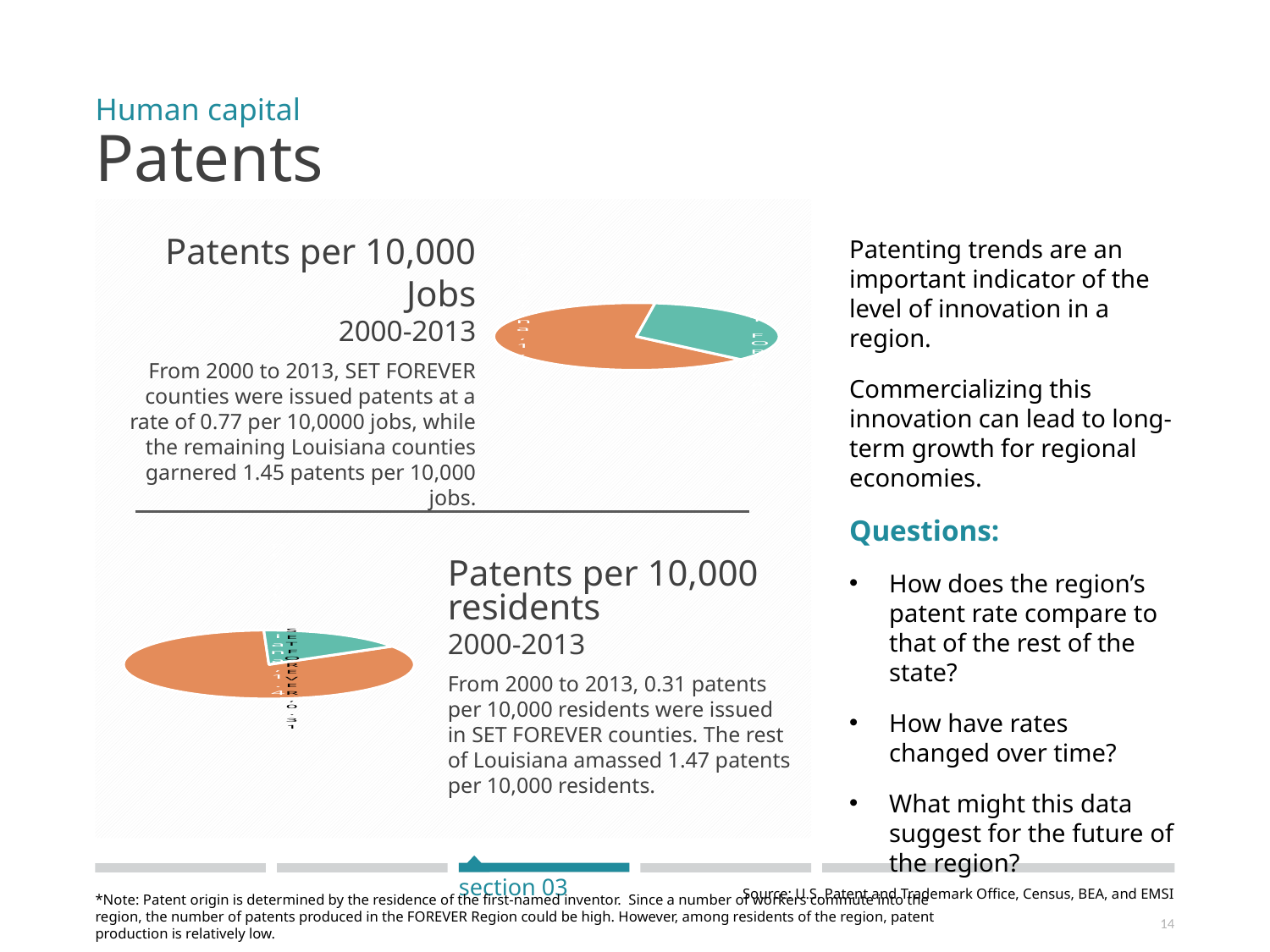
According to the slide, which had the higher rate of patents per 10,000 residents from 2000 to 2013, SET FOREVER counties or the rest of Louisiana? the rest of Louisiana What is the title of the pie chart at the top of the slide? Patents per 10,000 Jobs 2000-2013 What kind of chart is the 'Patents per 10,000 residents 2000-2013' chart? pie chart What time period do both pie charts on the slide cover? 2000-2013 How many slices does the 'Patents per 10,000 residents 2000-2013' pie chart have? 2 How many slices does the 'Patents per 10,000 Jobs 2000-2013' pie chart have? 2 According to the slide, which had the higher rate of patents per 10,000 jobs from 2000 to 2013, SET FOREVER counties or the remaining Louisiana counties? the remaining Louisiana counties In the 'Patents per 10,000 residents 2000-2013' chart, which slice is larger, the orange slice or the teal slice? the orange slice What kind of chart is the 'Patents per 10,000 Jobs 2000-2013' chart? pie chart